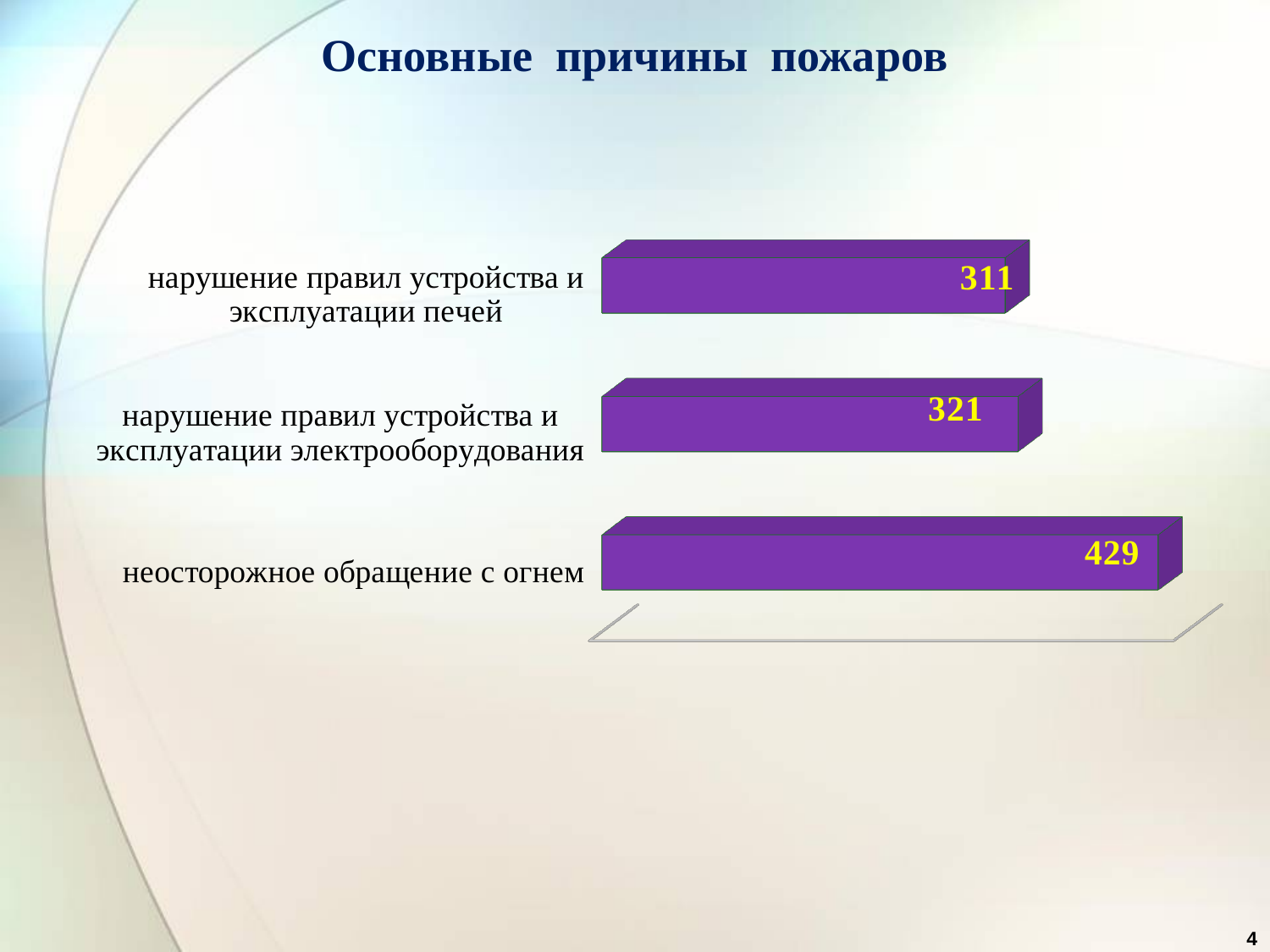
What is the difference between the values for "неосторожное обращение с огнем" and "нарушение правил устройства и эксплуатации печей"? 118 What is the value for "нарушение правил устройства и эксплуатации печей"? 311 Which is larger: the value for "неосторожное обращение с огнем" or for "нарушение правил устройства и эксплуатации электрооборудования"? неосторожное обращение с огнем What is the title of the slide? Основные причины пожаров What kind of chart is shown on the slide? bar chart Which category has the highest value? неосторожное обращение с огнем What is the difference between the values for "нарушение правил устройства и эксплуатации электрооборудования" and "нарушение правил устройства и эксплуатации печей"? 10 What is the value for "нарушение правил устройства и эксплуатации электрооборудования"? 321 What is the value for "неосторожное обращение с огнем"? 429 How many categories are shown in the chart? 3 Which category has the lowest value? нарушение правил устройства и эксплуатации печей What colour are the bars in the chart? purple